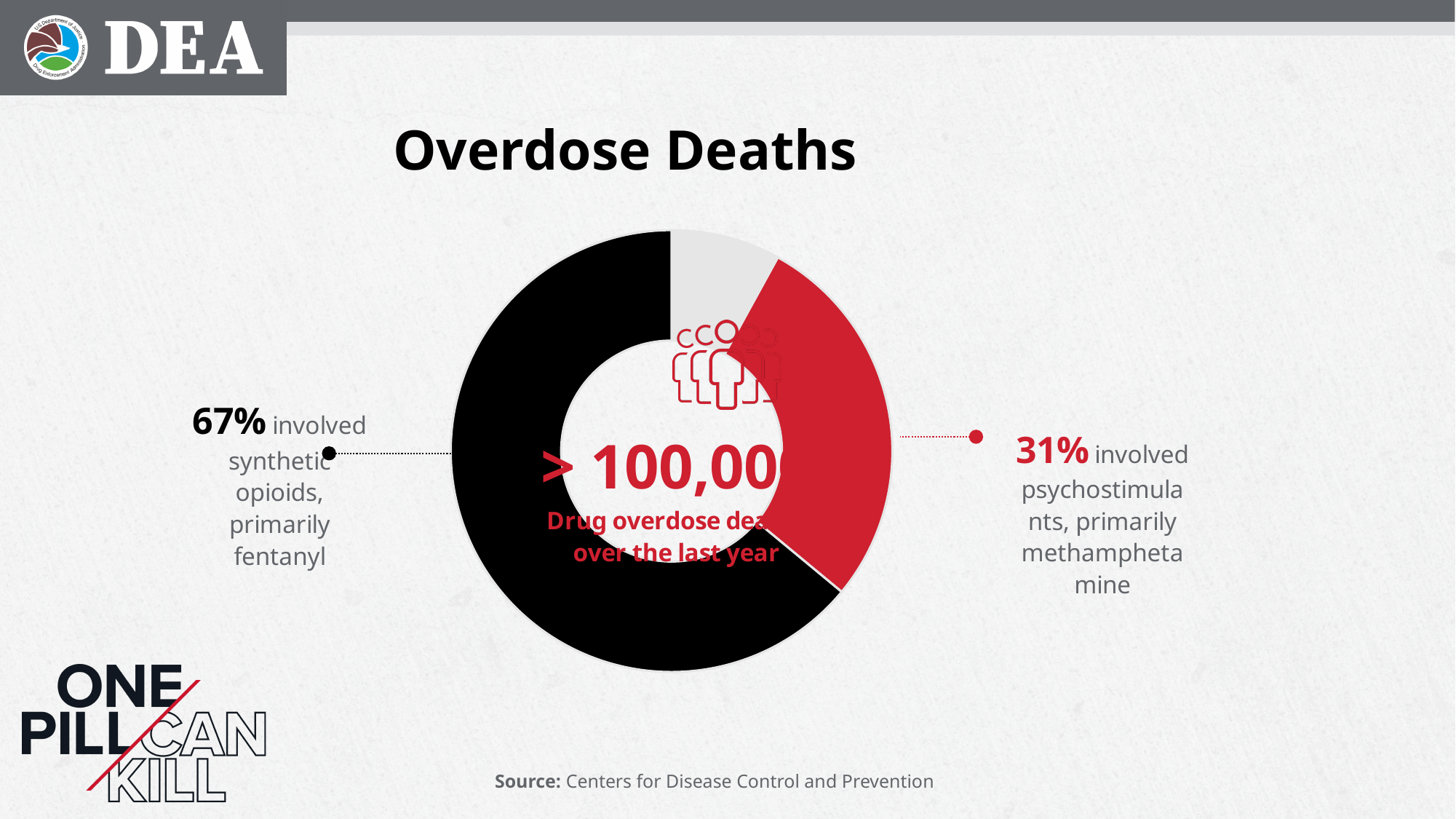
By how many percentage points does the synthetic opioids share exceed the psychostimulants share? 36 percentage points Which labelled category accounts for the smaller share: synthetic opioids or psychostimulants? Psychostimulants, primarily methamphetamine What figure is shown in the centre of the chart for drug overdose deaths over the last year? > 100,000 What is the source cited for the chart data? Centers for Disease Control and Prevention What percentage of overdose deaths involved synthetic opioids, primarily fentanyl? 67% Which is larger, the share for synthetic opioids or the share for psychostimulants? Synthetic opioids What percentage of overdose deaths involved psychostimulants, primarily methamphetamine? 31% What kind of chart is shown on the slide? Doughnut chart Which labelled category accounts for the largest share of the chart? Synthetic opioids, primarily fentanyl What is the title of the chart? Overdose Deaths What colour is the slice representing synthetic opioids? Black How many slices does the chart have? 3